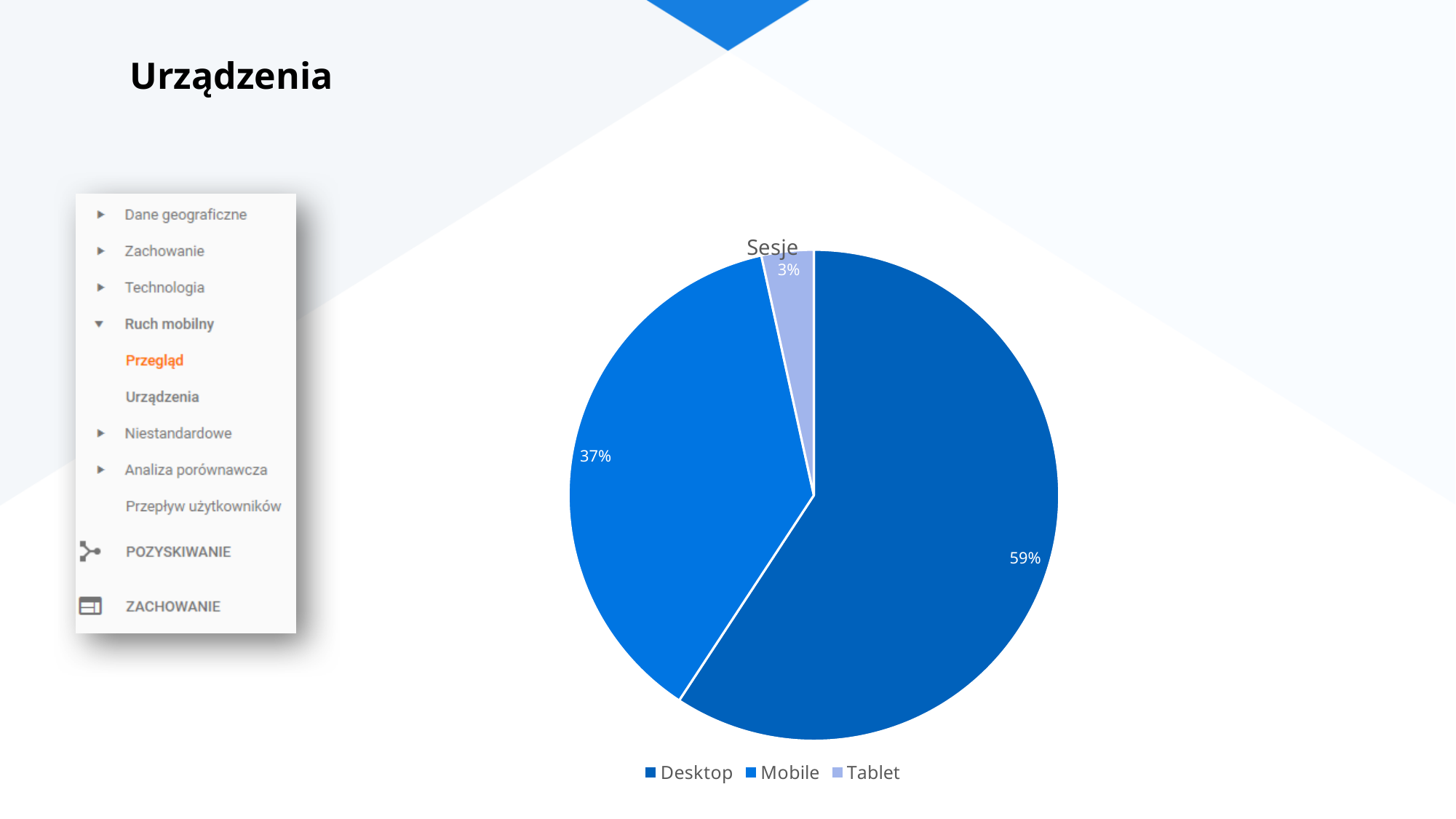
What is the title of the chart? Sesje How many categories does the pie chart show? 3 What is the difference in percentage points between the Desktop and Mobile slices? 22 Which categories are listed in the legend, in order? Desktop, Mobile, Tablet Which category has the largest slice of the pie? Desktop What share of the pie does Tablet have? 3% Which category has the smallest slice of the pie? Tablet What kind of chart is shown on the slide? pie chart What is the difference in percentage points between the Mobile and Tablet slices? 34 Which is larger, the Mobile slice or the Tablet slice? Mobile What share of the pie does Desktop have? 59% What share of the pie does Mobile have? 37%